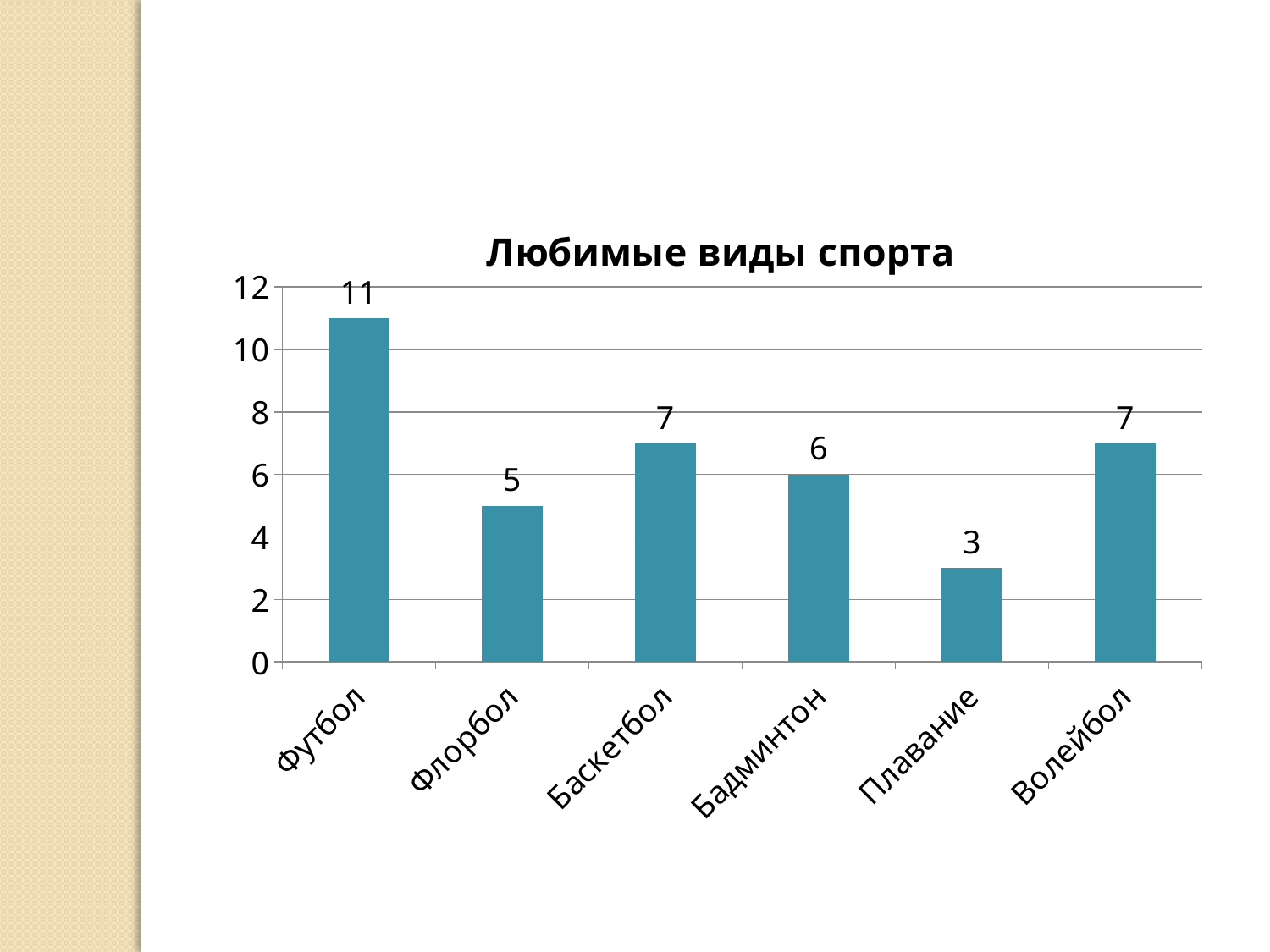
What is the value for Плавание? 3 What is the title of the chart? Любимые виды спорта Is the value for Футбол greater or less than 10? greater What is the difference between the values for Волейбол and Плавание? 4 What is the value for Футбол? 11 How many sports are shown on the chart? 6 Which sport has the lowest value? Плавание What is the difference between the values for Футбол and Флорбол? 6 What is the value for Бадминтон? 6 Which is larger, the value for Баскетбол or the value for Бадминтон? Баскетбол What kind of chart is shown on the slide? bar chart Which sport has the highest value? Футбол